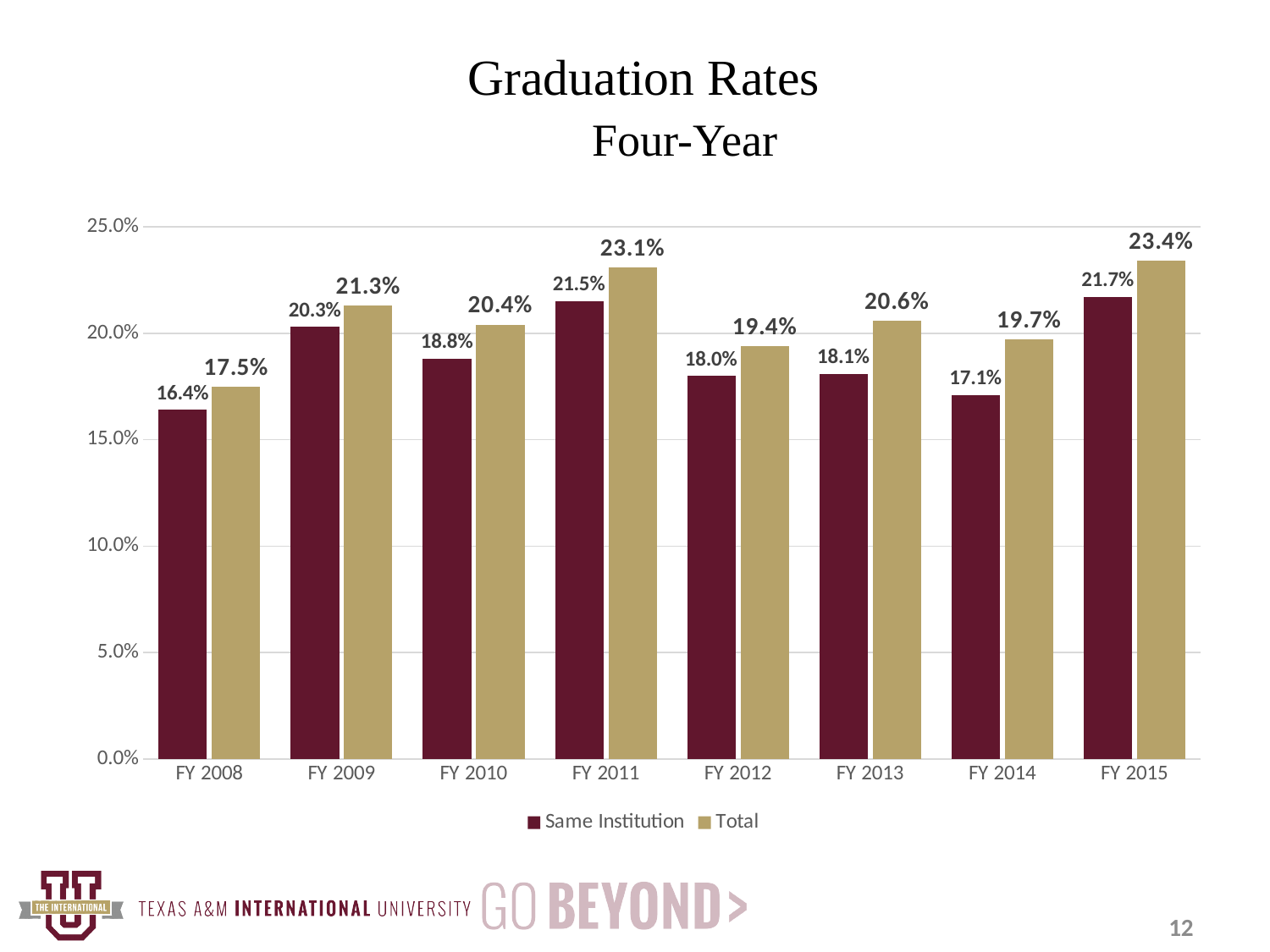
How many series does the legend list? 2 What are the two series named in the legend? Same Institution and Total Which is larger, the Total rate for FY 2009 or the Total rate for FY 2013? FY 2009 What kind of chart is shown on the slide? Bar chart What is the difference between the Total and Same Institution rates for FY 2014? 2.6% Does the Same Institution rate rise or fall from FY 2011 to FY 2012? Fall Which fiscal year has the highest Total graduation rate? FY 2015 Which fiscal year has the lowest Same Institution graduation rate? FY 2008 What is the Same Institution graduation rate for FY 2011? 21.5% What is the Total graduation rate for FY 2015? 23.4% What is the Same Institution value for FY 2014? 17.1% How many fiscal years are shown on the x axis? 8